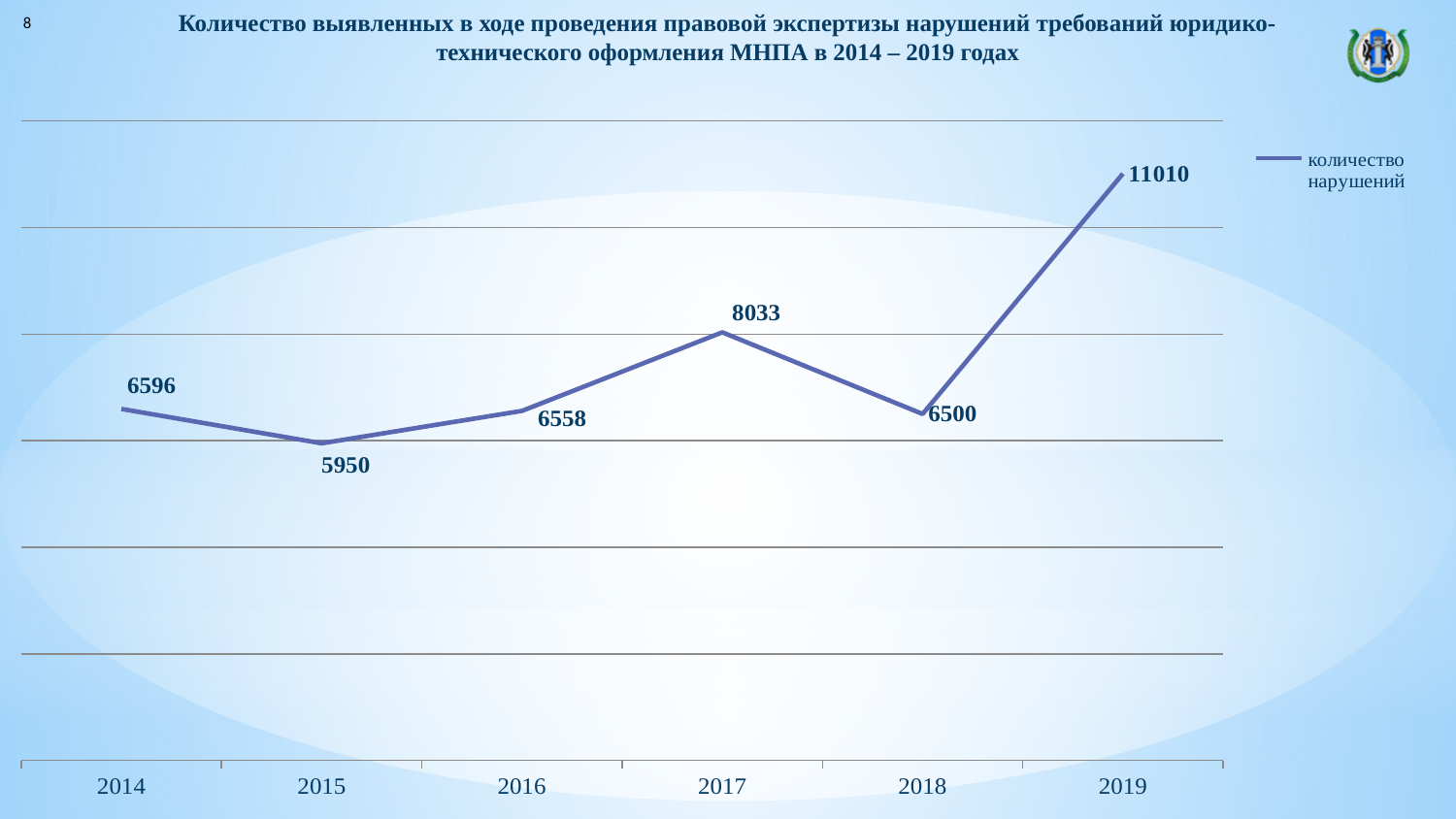
What is the value for 2014? 6596 What kind of chart is shown on the slide? line chart What is the difference between the values for 2017 and 2016? 1475 Which year has the highest value? 2019 How many years are plotted on the chart? 6 Which year has the lowest value? 2015 What is the difference between the values for 2019 and 2018? 4510 What is the legend entry for the plotted series? количество нарушений What is the value for 2019? 11010 What is the value for 2017? 8033 How many series does the legend list? 1 Which is larger, the value for 2014 or the value for 2016? 2014